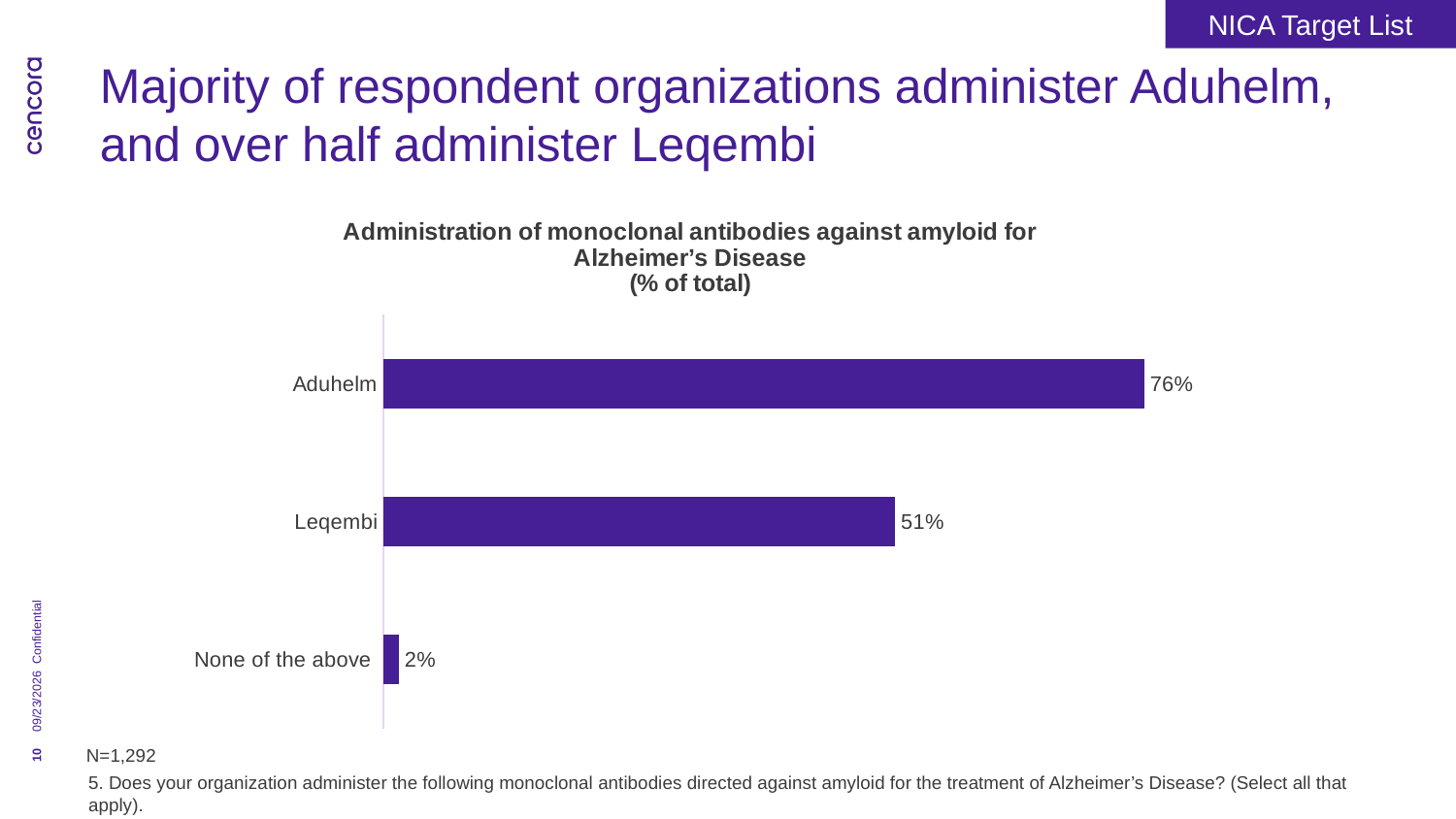
What is the sample size (N) stated below the chart? N=1,292 What percentage of respondent organizations administer Aduhelm? 76% What is the value shown for 'None of the above'? 2% What is the difference in percentage points between Leqembi and 'None of the above'? 49 What percentage of respondent organizations administer Leqembi? 51% How many categories are shown in the chart? 3 Which category has the lowest value in the chart? None of the above What is the title of the chart? Administration of monoclonal antibodies against amyloid for Alzheimer's Disease (% of total) What is the difference in percentage points between Aduhelm and Leqembi? 25 What type of chart is shown on the slide? Bar chart Which category has the highest value in the chart? Aduhelm Which has a larger value, Aduhelm or Leqembi? Aduhelm